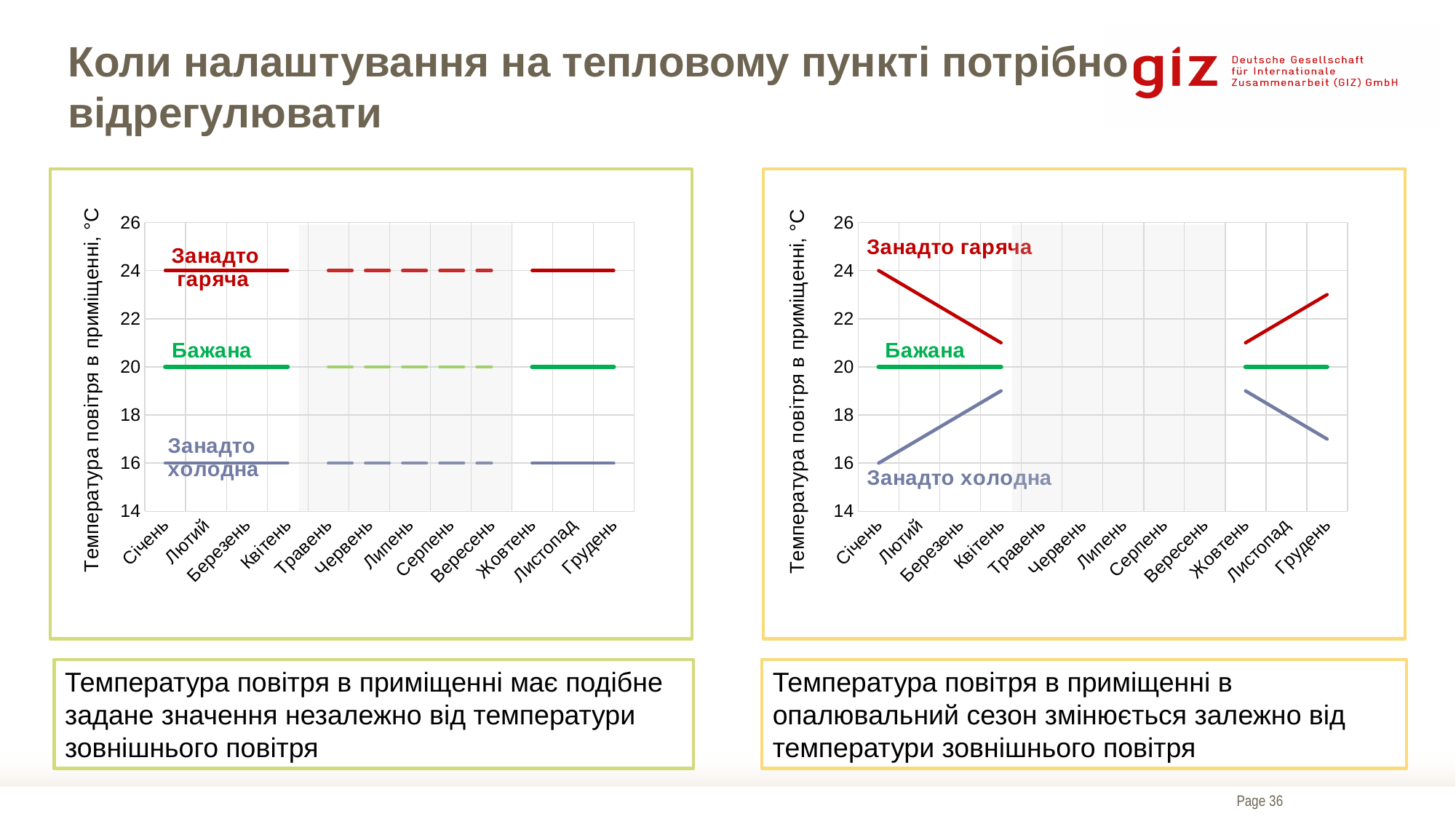
On the right chart, what is the value of the 'Занадто гаряча' line in Січень? 24 On the left chart, what is the value of the 'Занадто холодна' line in Лютий? 16 On the right chart, is the value of the 'Занадто холодна' line in Грудень greater or less than 18? less On the left chart, what is the difference between the 'Занадто гаряча' and 'Занадто холодна' lines in Березень? 8 On the left chart, what is the value of the 'Занадто гаряча' line in Грудень? 24 What kind of chart is the left chart? line chart How many months are shown on the x axis of the left chart? 12 On the right chart, what is the value of the 'Занадто холодна' line in Січень? 16 On the left chart, what is the value of the 'Бажана' line in Січень? 20 On the right chart, does the 'Занадто гаряча' line rise or fall from Січень to Квітень? falls How many labelled series are plotted on the right chart? 3 On the left chart, does the 'Бажана' line rise, fall or stay flat from Січень to Грудень? stays flat